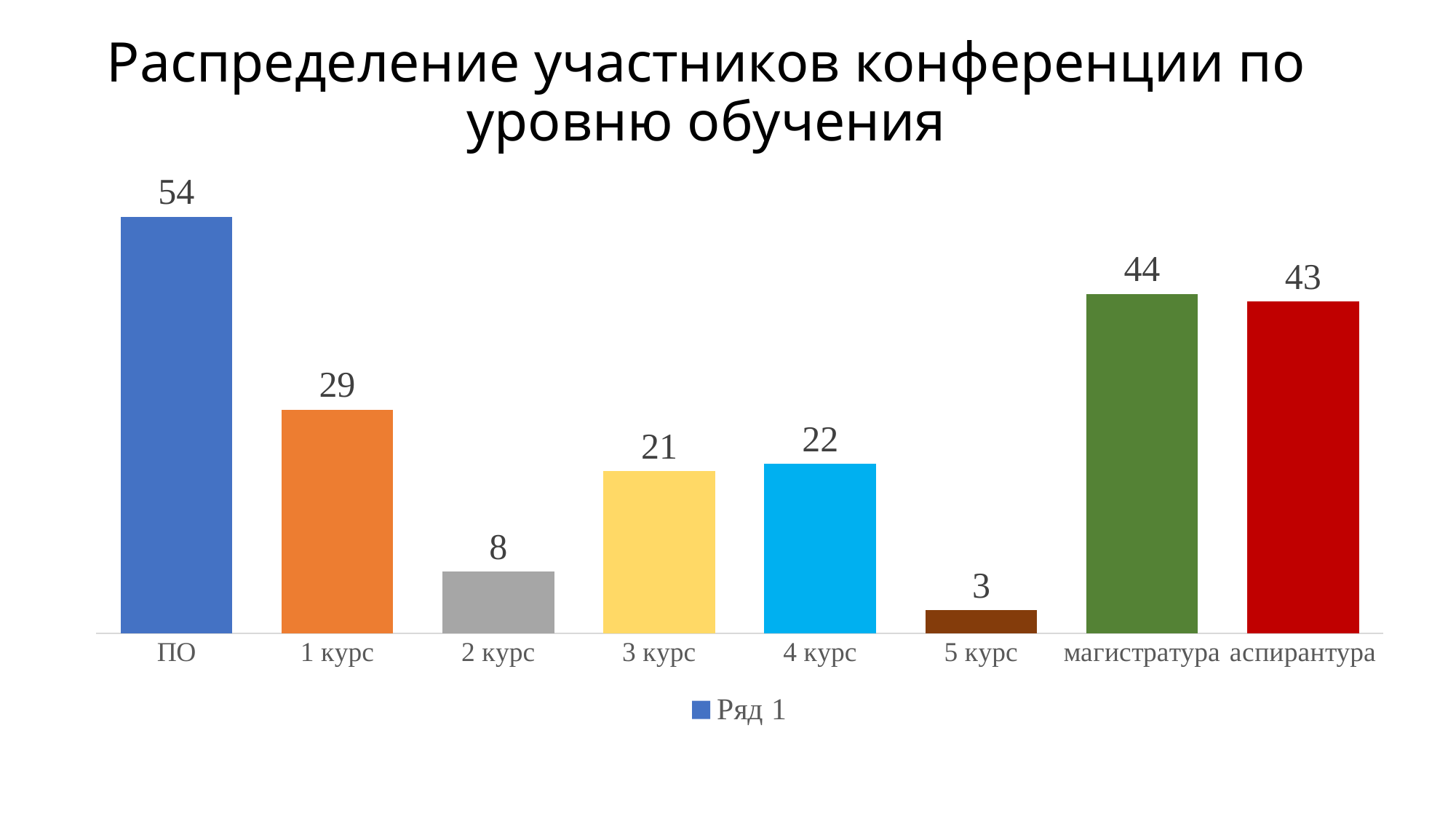
Which is larger, the value for 3 курс or the value for 4 курс? 4 курс Which category has the highest value? ПО Which category has the lowest value? 5 курс Which is larger, the value for магистратура or the value for аспирантура? магистратура What is the name of the series listed in the legend? Ряд 1 What is the value for 5 курс? 3 What kind of chart is shown on the slide? bar chart What is the value for ПО? 54 What is the value for магистратура? 44 What is the difference between the values for ПО and аспирантура? 11 How many categories are shown on the x axis? 8 What is the difference between the values for 1 курс and 2 курс? 21